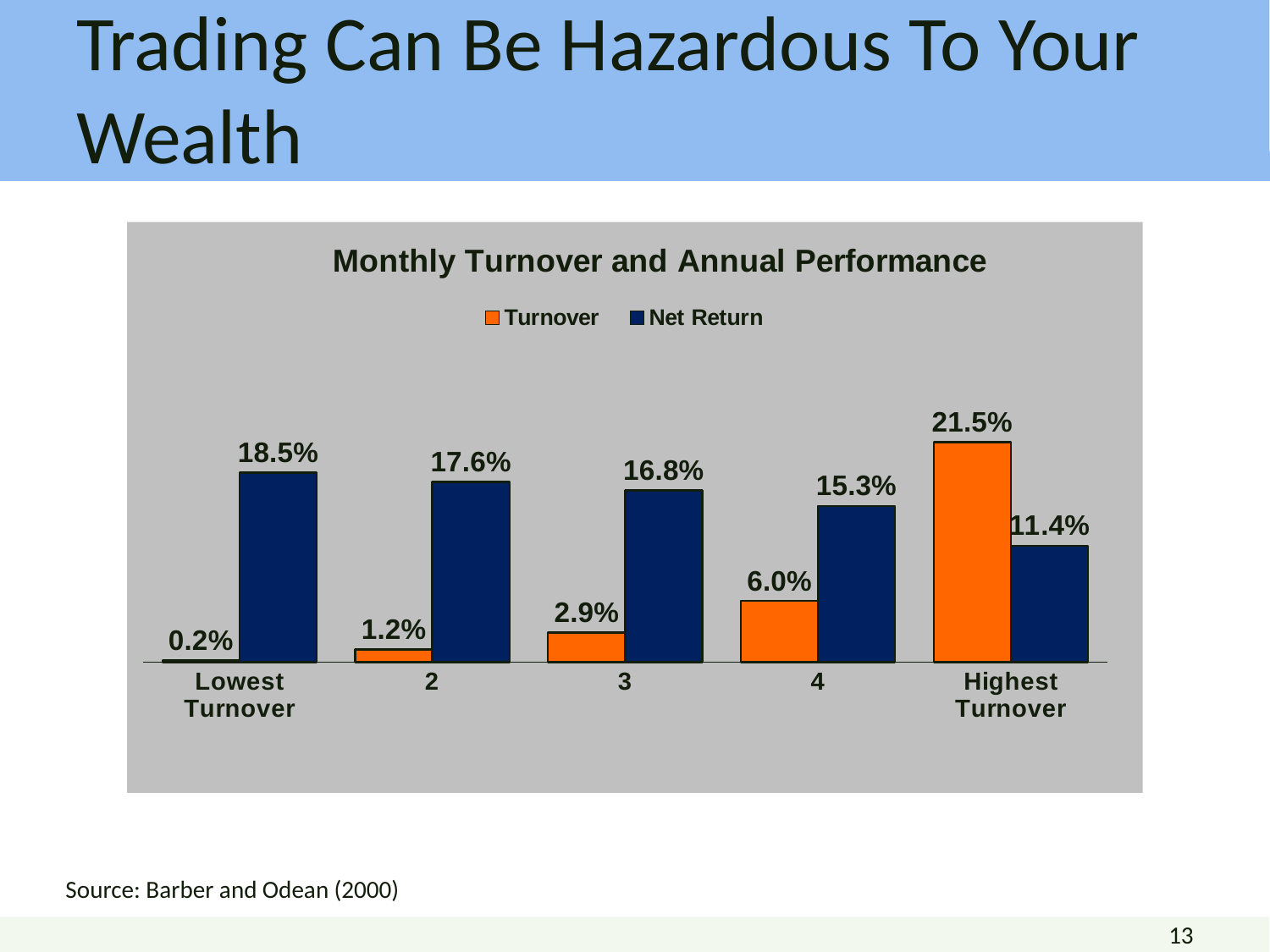
Which group has the lowest Turnover value? Lowest Turnover What is the Turnover value for group 3? 2.9% What is the Net Return for the Lowest Turnover group? 18.5% What is the Turnover value for the Highest Turnover group? 21.5% How many series does the legend list? 2 How many turnover groups are shown on the x axis? 5 What is the Net Return for group 4? 15.3% What kind of chart is shown on the slide? Bar chart Which group has the highest Net Return? Lowest Turnover What is the difference between the Net Return of the Lowest Turnover group and the Highest Turnover group? 7.1% Which is larger for the Highest Turnover group, Turnover or Net Return? Turnover Does Net Return rise or fall as you move from Lowest Turnover to Highest Turnover? Fall